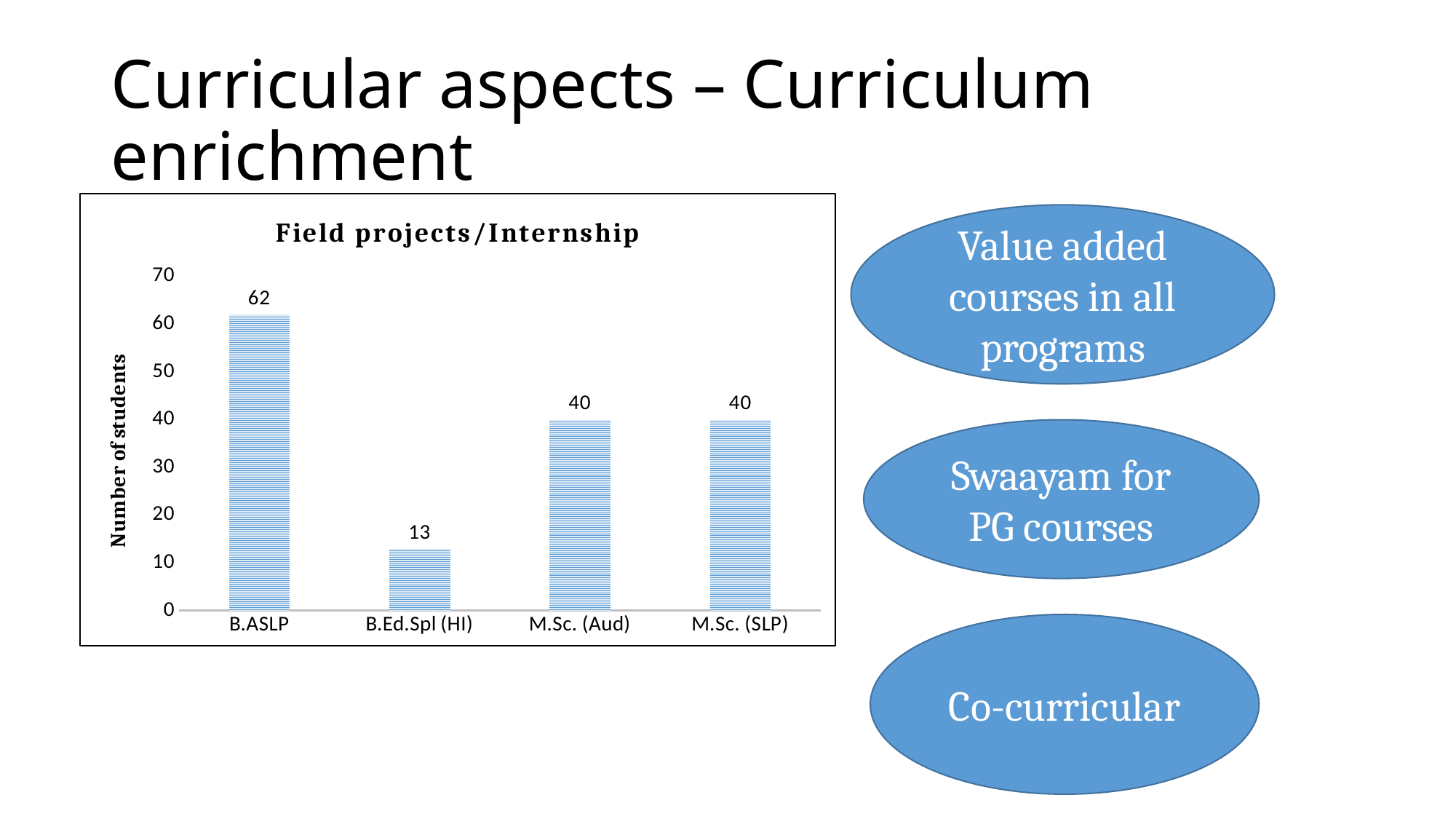
Which has more students, B.Ed.Spl (HI) or M.Sc. (SLP)? M.Sc. (SLP) What is the difference in number of students between B.ASLP and B.Ed.Spl (HI)? 49 What is the number of students for M.Sc. (Aud)? 40 How many programs are shown in the Field projects/Internship chart? 4 What is the number of students for B.Ed.Spl (HI)? 13 What is the label of the vertical axis in the chart? Number of students Which program has the highest number of students in field projects/internship? B.ASLP What is the number of students for M.Sc. (SLP)? 40 What type of chart is used to show Field projects/Internship? Bar chart What is the number of students for B.ASLP in the Field projects/Internship chart? 62 Which program has the lowest number of students in field projects/internship? B.Ed.Spl (HI) What is the difference in number of students between B.ASLP and M.Sc. (Aud)? 22